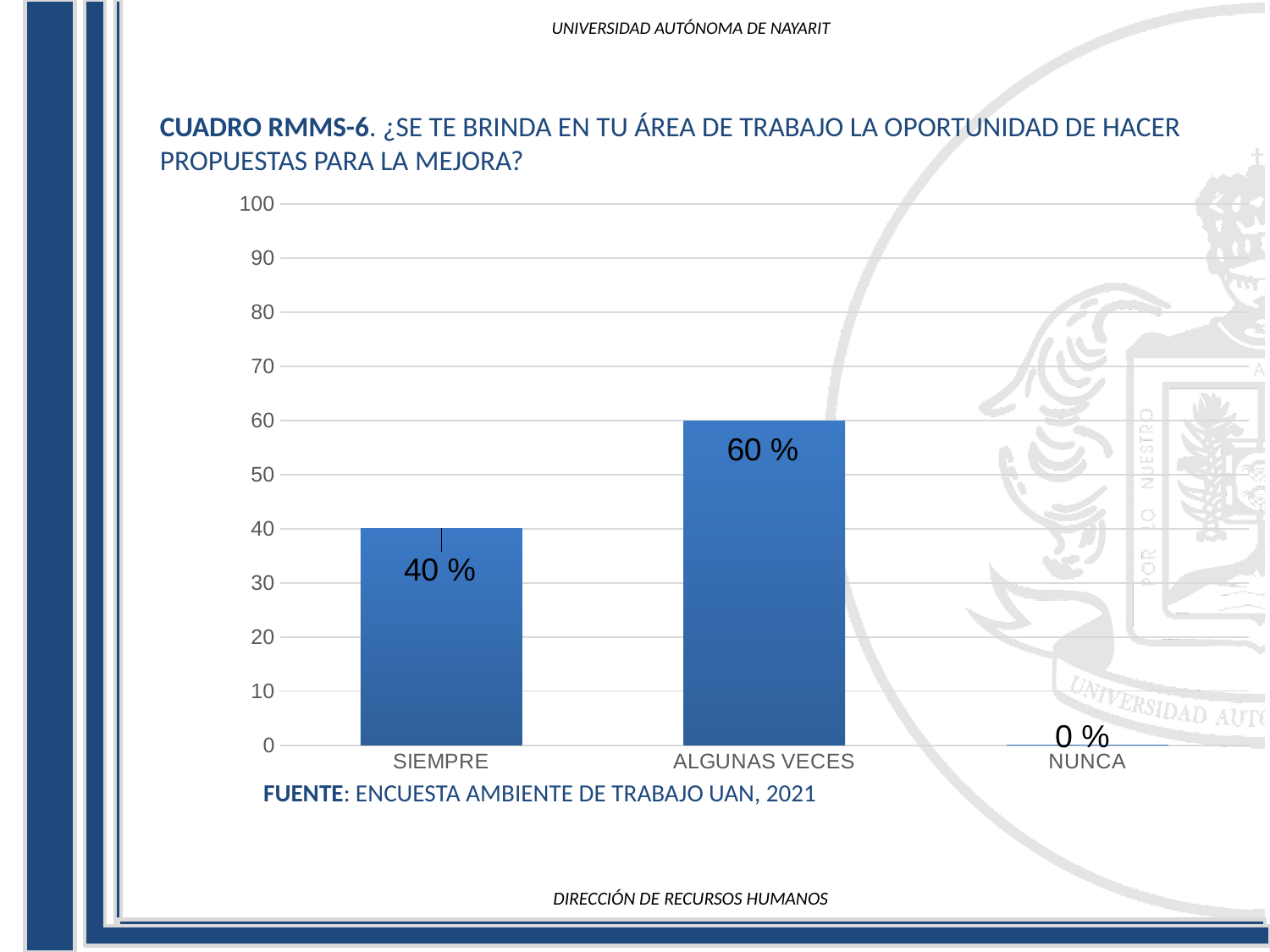
What is the value for NUNCA? 0 % What source is cited below the chart? ENCUESTA AMBIENTE DE TRABAJO UAN, 2021 Which category has the highest value? ALGUNAS VECES What is the maximum value shown on the y axis? 100 Is the value for ALGUNAS VECES greater or less than 50? greater What is the difference between the values for ALGUNAS VECES and SIEMPRE? 20 % Which category has the lowest value? NUNCA What kind of chart is shown on the slide? bar chart How many categories are shown on the x axis? 3 Which is larger, the value for SIEMPRE or the value for ALGUNAS VECES? ALGUNAS VECES What is the value for ALGUNAS VECES? 60 % What is the value for SIEMPRE? 40 %